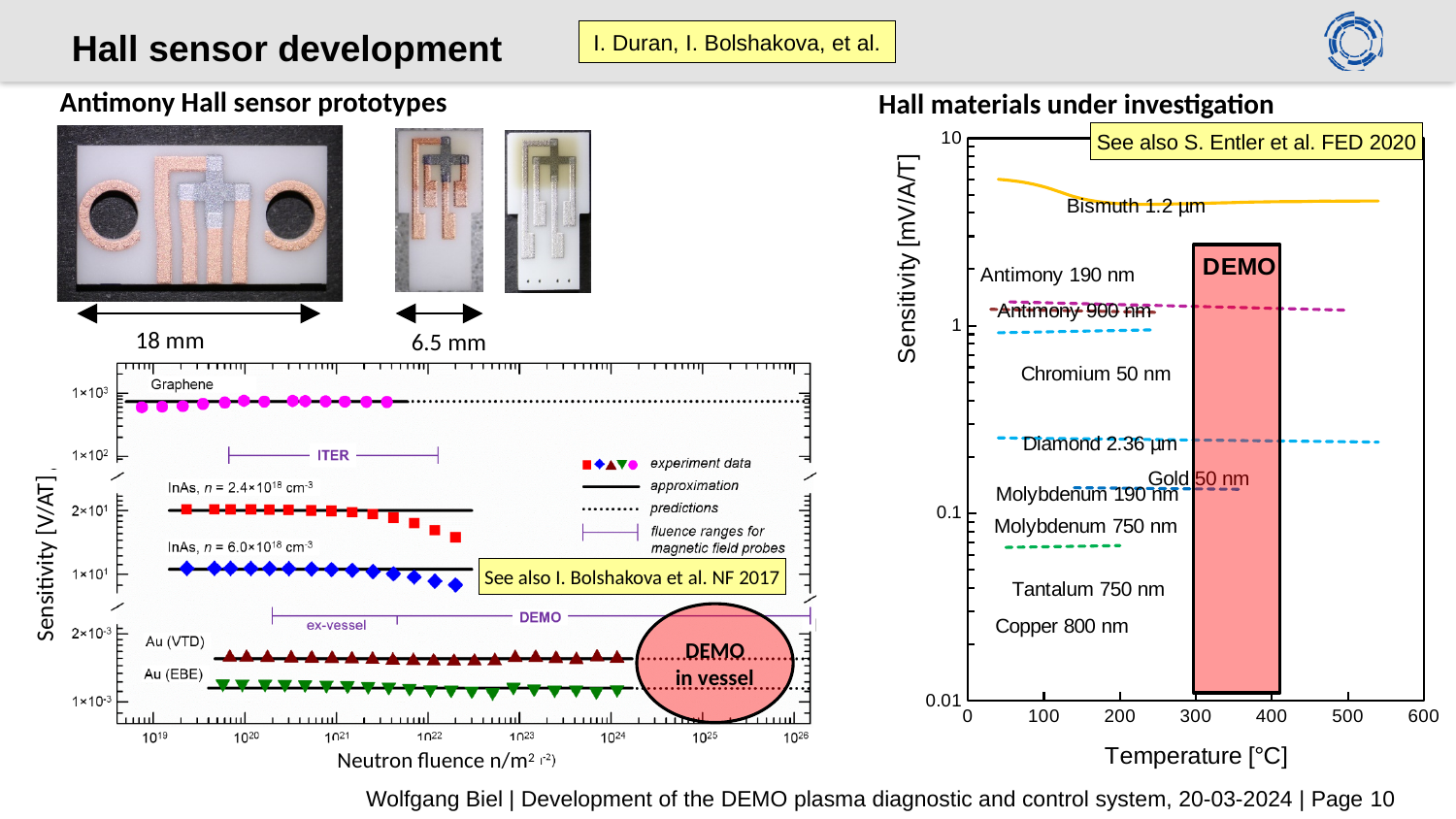
In the 'Hall materials under investigation' chart, what temperature range does the shaded DEMO box cover? 300 to 400 °C In the neutron fluence chart on the left, which material has the lowest sensitivity? Au (EBE) In the 'Hall materials under investigation' chart, what is the label of the x axis? Temperature [°C] In the 'Hall materials under investigation' chart, is the sensitivity of Diamond 2.36 µm greater or less than 1 mV/A/T? less In the neutron fluence chart on the left, which material has the highest sensitivity? Graphene In the 'Hall materials under investigation' chart, is the sensitivity of Molybdenum 750 nm greater or less than 0.1 mV/A/T? less In the neutron fluence chart on the left, how many data series are plotted? 5 In the neutron fluence chart on the left, does the sensitivity of InAs with n = 2.4×10^18 cm^-3 rise, fall or stay flat at the highest fluences measured? fall In the 'Hall materials under investigation' chart, is the sensitivity of Bismuth 1.2 µm greater or less than 1 mV/A/T? greater What kind of chart is the 'Hall materials under investigation' chart on the right? line chart In the 'Hall materials under investigation' chart, which material has the highest sensitivity? Bismuth 1.2 µm In the 'Hall materials under investigation' chart, which has the higher sensitivity, Bismuth 1.2 µm or Gold 50 nm? Bismuth 1.2 µm